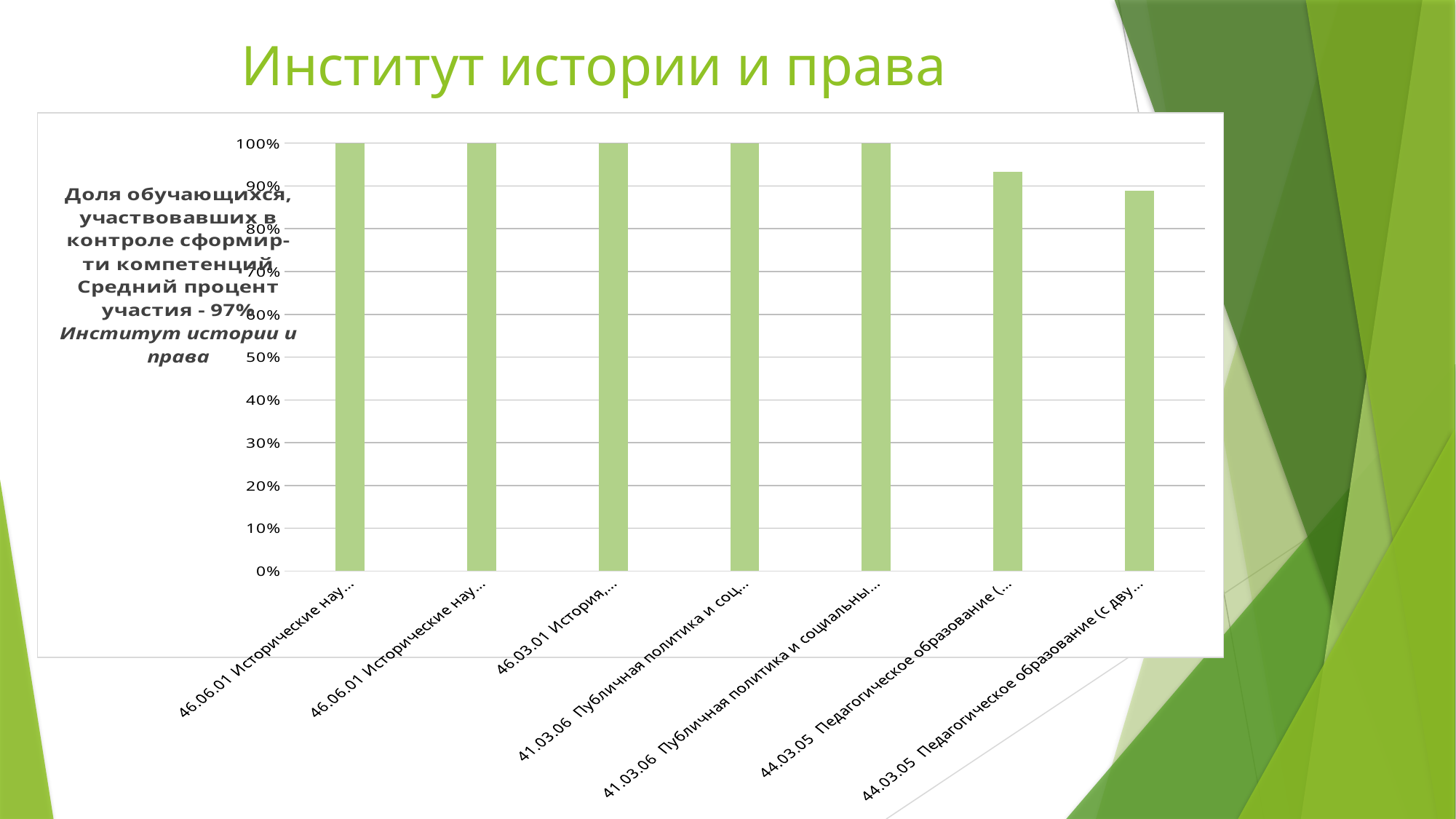
Do the bar values rise or fall moving from left to right across the chart? fall What kind of chart is shown on the slide? bar chart Which is larger: the value for "46.03.01 История,..." or the value of the rightmost bar? 46.03.01 История,... How many bars reach the 100% line? 5 What is the value of the leftmost bar ("46.06.01 Исторические нау...")? 100% According to the chart's title text, what is the average participation percentage (Средний процент участия)? 97% What colour are the bars in the chart? green Which category has the lowest value? 44.03.05 Педагогическое образование (с дву... What is the value for the category "46.03.01 История,..."? 100% How many bars (categories) does the chart show? 7 Is the value of the sixth bar from the left ("44.03.05 Педагогическое образование (...") greater or less than 90%? greater